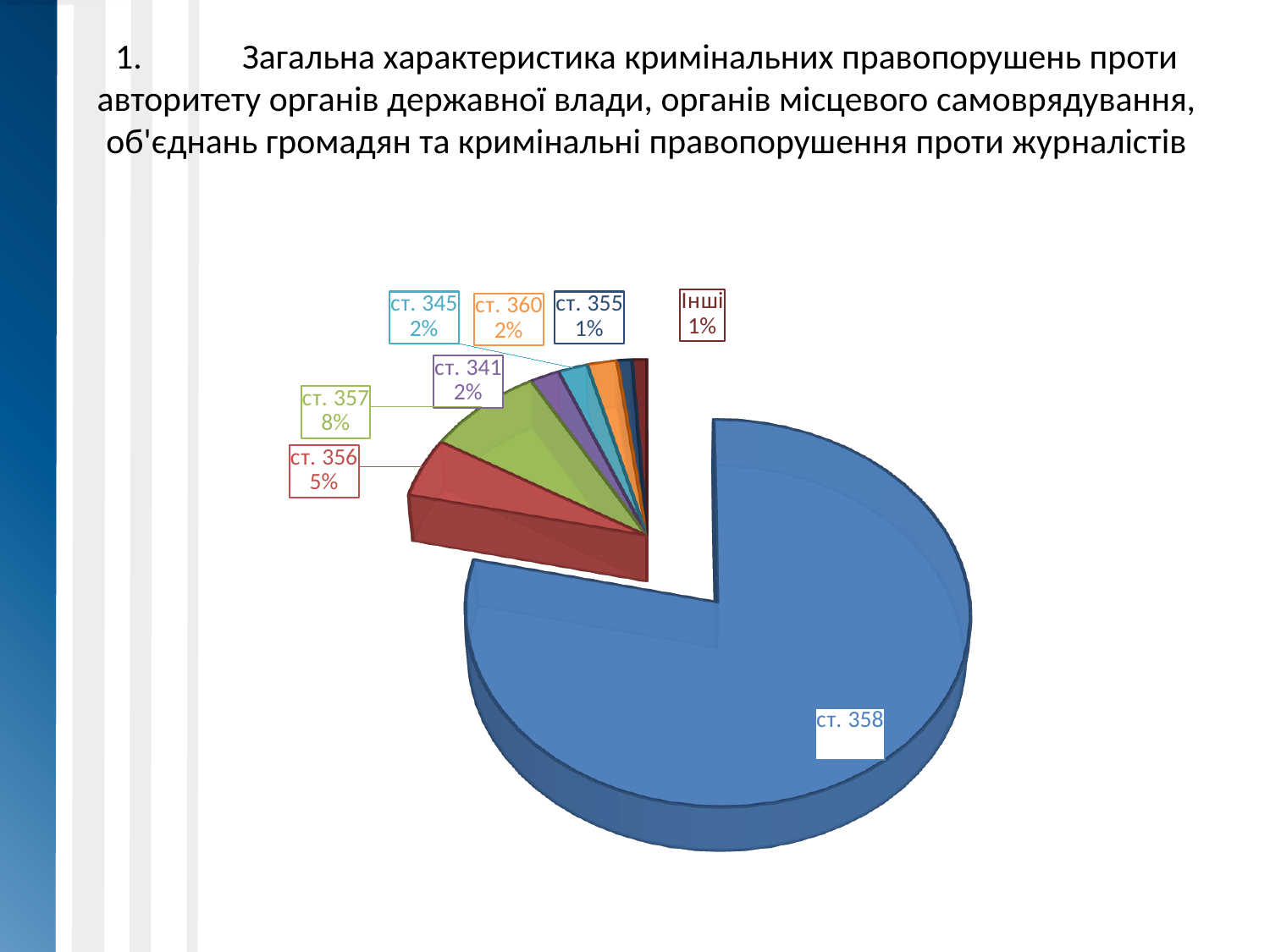
What kind of chart is shown on the slide? pie chart What share of the pie does ст. 345 represent? 2% What share of the pie does ст. 356 represent? 5% What share of the pie does ст. 355 represent? 1% How many slices does the pie chart have? 8 Which slice of the pie is the largest? ст. 358 Which slice is larger, ст. 357 or ст. 356? ст. 357 What is the difference in percentage points between the ст. 357 slice and the ст. 356 slice? 3